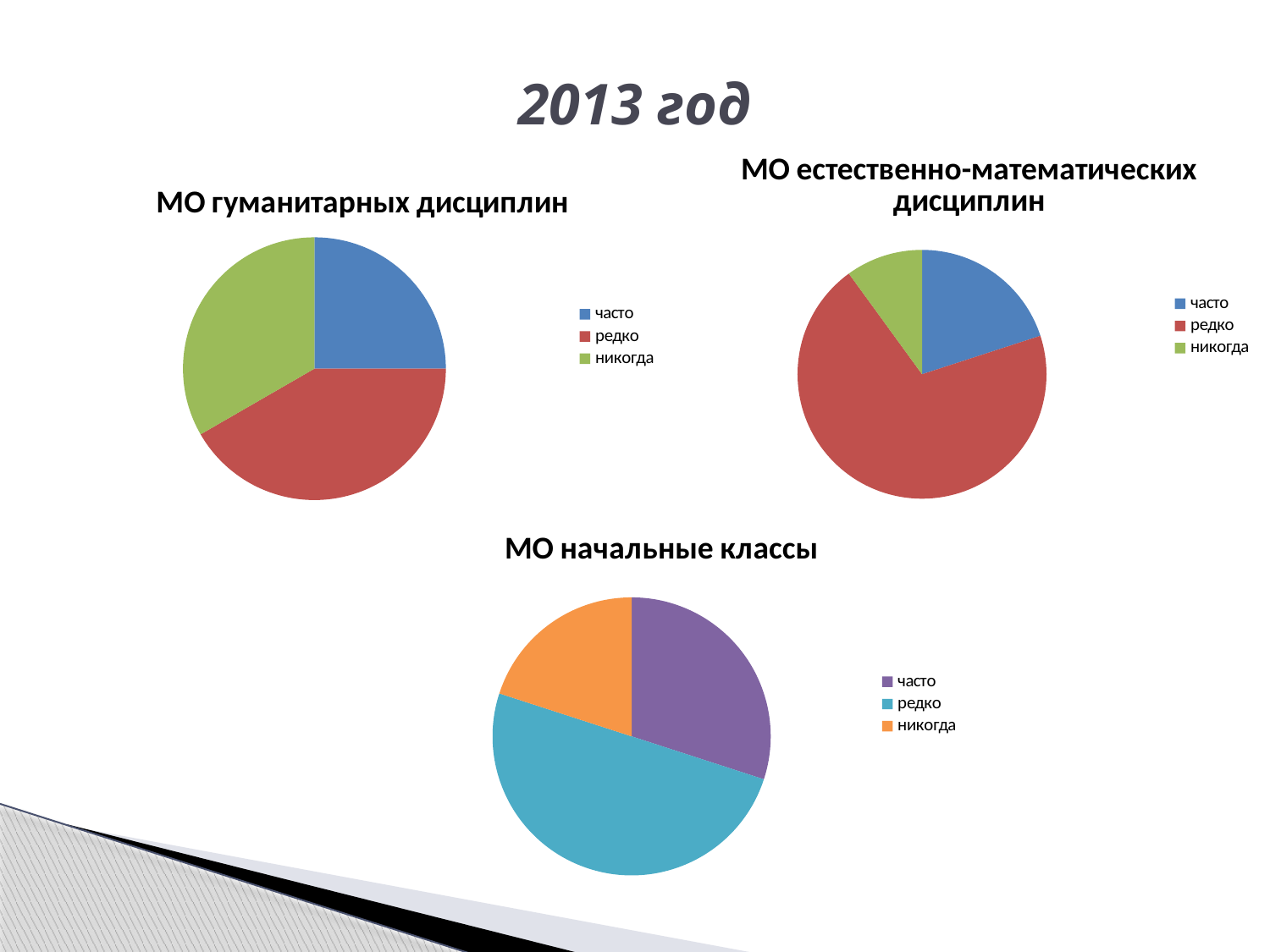
What colour is the "редко" slice in the "МО начальные классы" chart? teal (blue-green) In the "МО естественно-математических дисциплин" chart, which slice is larger: часто or никогда? часто What is the title of the pie chart at the bottom of the slide? МО начальные классы How many entries does the legend of the "МО естественно-математических дисциплин" chart list? 3 In the "МО начальные классы" chart, which slice is larger: часто or никогда? часто In the "МО гуманитарных дисциплин" chart, which category has the smallest slice? часто In the "МО начальные классы" chart, which category has the largest slice? редко How many slices does the "МО начальные классы" pie chart have? 3 What kind of chart is "МО гуманитарных дисциплин"? pie chart In the "МО естественно-математических дисциплин" chart, which category has the largest slice? редко In the "МО начальные классы" chart, which category has the smallest slice? никогда In the "МО естественно-математических дисциплин" chart, which category has the smallest slice? никогда